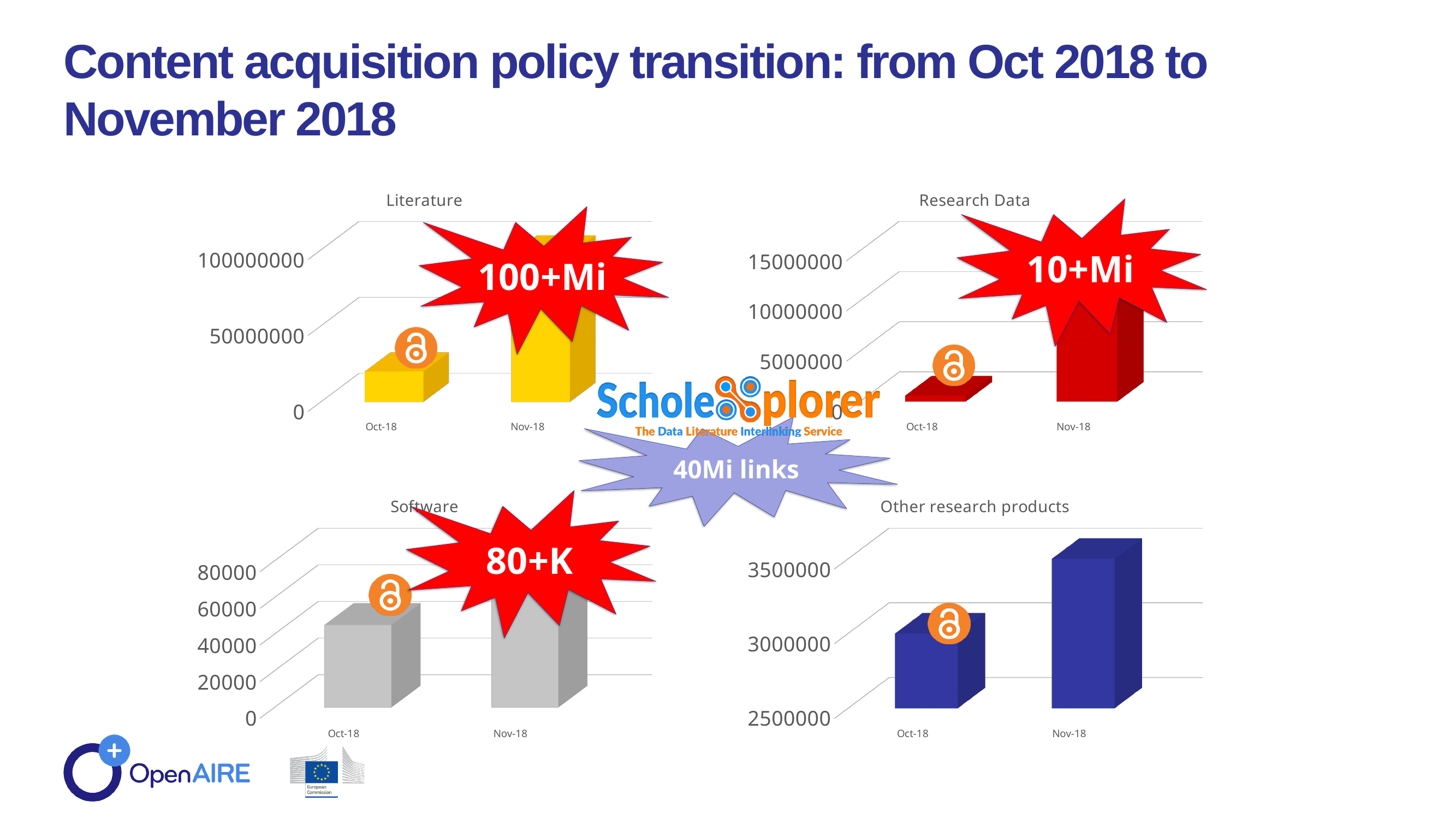
What kind of chart is the Literature chart? bar chart In the Other research products chart, which category has the highest value? Nov-18 In the Literature chart, is the value for Oct-18 greater or less than 50000000? less How many categories are shown on the x axis of the Software chart? 2 In the Research Data chart, is the value for Oct-18 greater or less than 5000000? less In the Literature chart, which category has the higher value, Oct-18 or Nov-18? Nov-18 In the Software chart, is the value for Nov-18 greater or less than 60000? greater In the Software chart, do the values rise or fall from Oct-18 to Nov-18? rise What is the title of the chart in the bottom-right of the slide? Other research products In the Research Data chart, which category has the lowest value? Oct-18